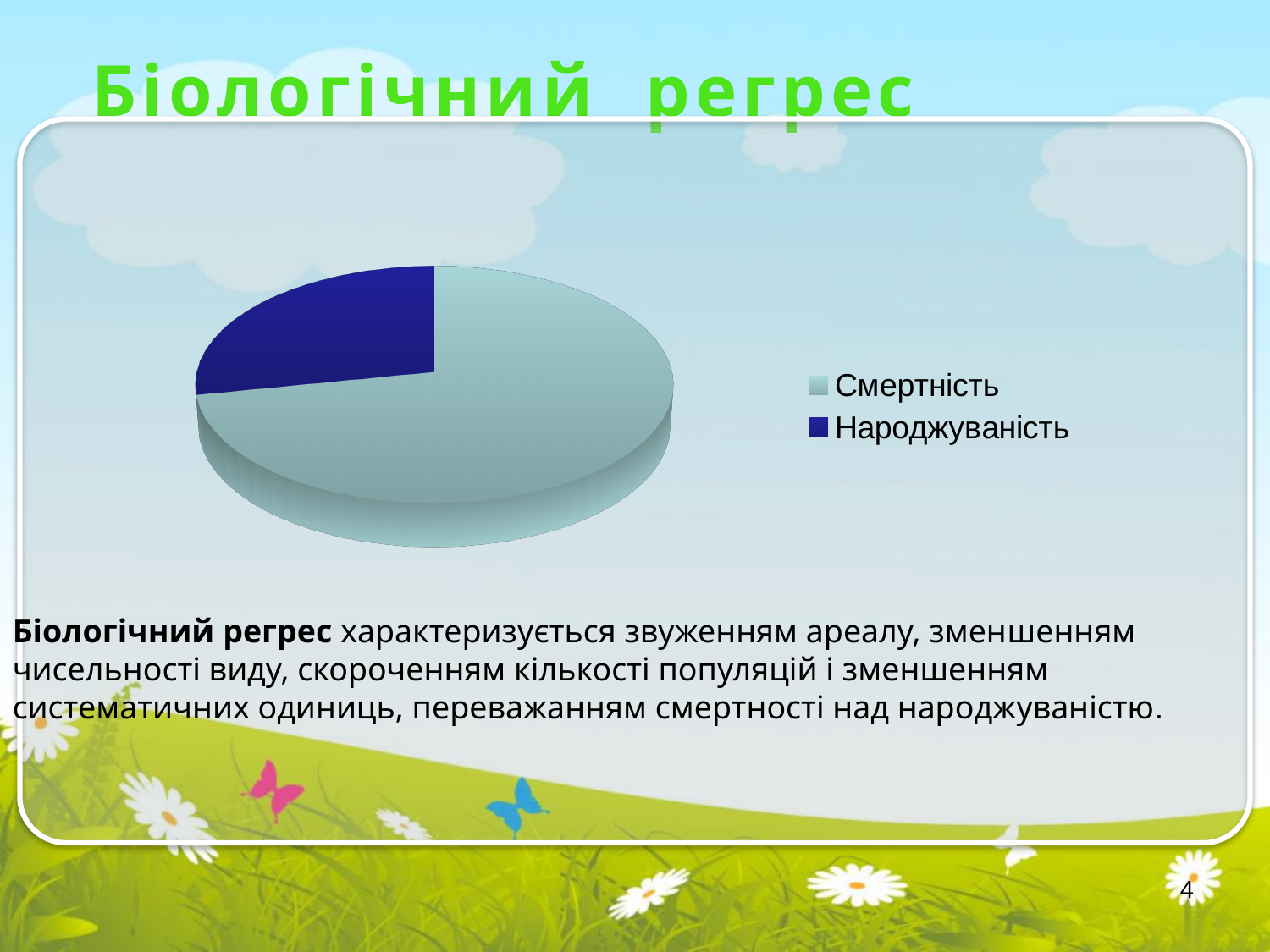
Which category has the smallest slice in the pie chart? Народжуваність How many slices does the pie chart have? 2 How many entries does the legend of the pie chart list? 2 Which category has the largest slice in the pie chart? Смертність Is the slice for Народжуваність larger or smaller than the slice for Смертність? smaller Which slice is larger in the pie chart, Смертність or Народжуваність? Смертність What are the two legend entries of the pie chart? Смертність, Народжуваність What kind of chart is shown on the slide? pie chart What colour is the Народжуваність slice in the pie chart? dark blue